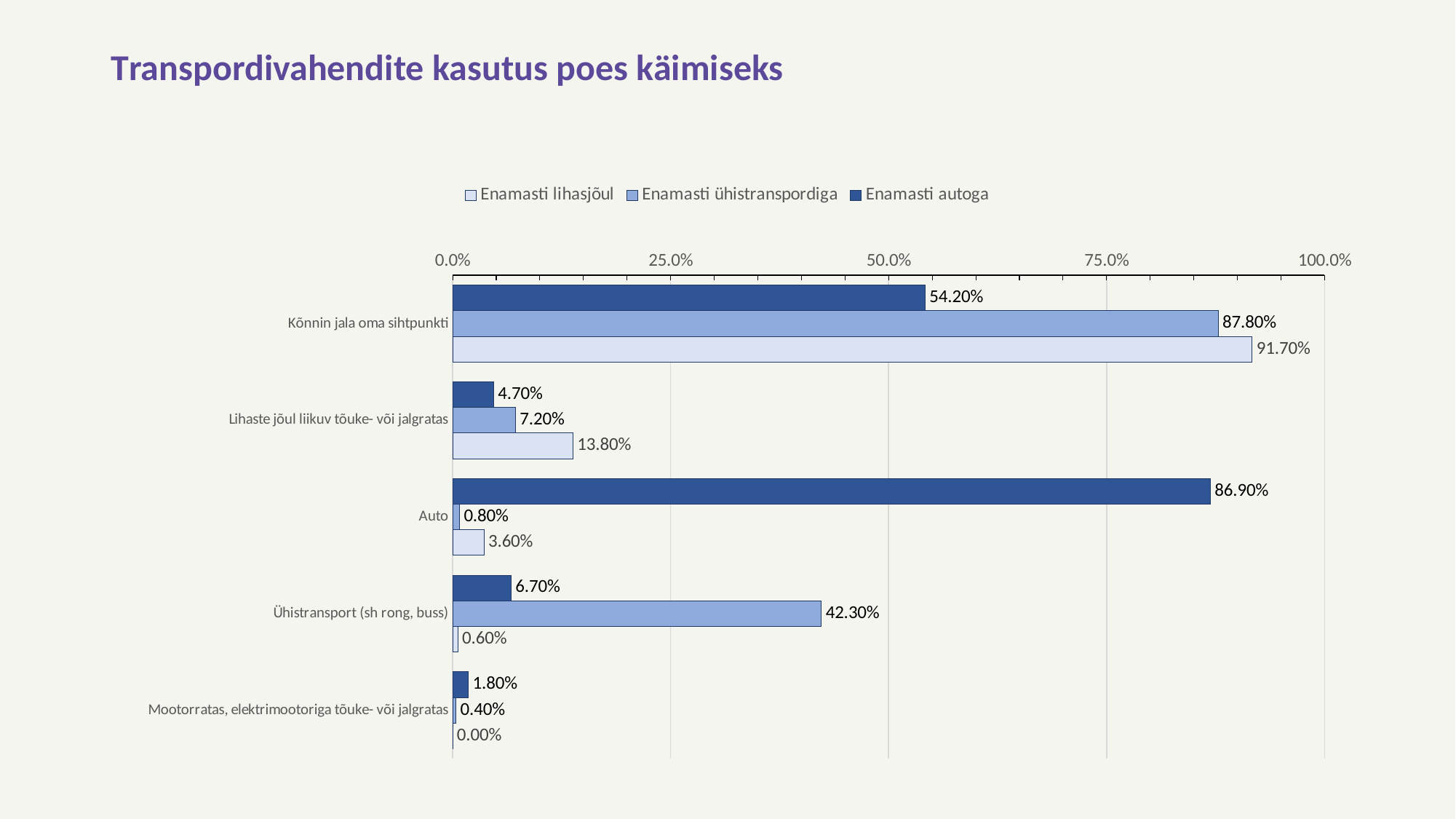
How many series does the legend list? 3 What is the value for Ühistransport (sh rong, buss) in the Enamasti ühistranspordiga series? 42.30% Is the Enamasti autoga value for Kõnnin jala oma sihtpunkti greater or less than 50.0%? greater What is the value for Kõnnin jala oma sihtpunkti in the Enamasti lihasjõul series? 91.70% Which category has the lowest value in the Enamasti lihasjõul series? Mootorratas, elektrimootoriga tõuke- või jalgratas What type of chart is shown on the slide? Bar chart What is the value for Lihaste jõul liikuv tõuke- või jalgratas in the Enamasti lihasjõul series? 13.80% What is the value for Auto in the Enamasti autoga series? 86.90% For Auto, which series has the larger value: Enamasti autoga or Enamasti lihasjõul? Enamasti autoga How many categories are shown on the chart? 5 Which category has the highest value in the Enamasti ühistranspordiga series? Kõnnin jala oma sihtpunkti What is the difference between the Enamasti lihasjõul and Enamasti autoga values for Kõnnin jala oma sihtpunkti? 37.50%